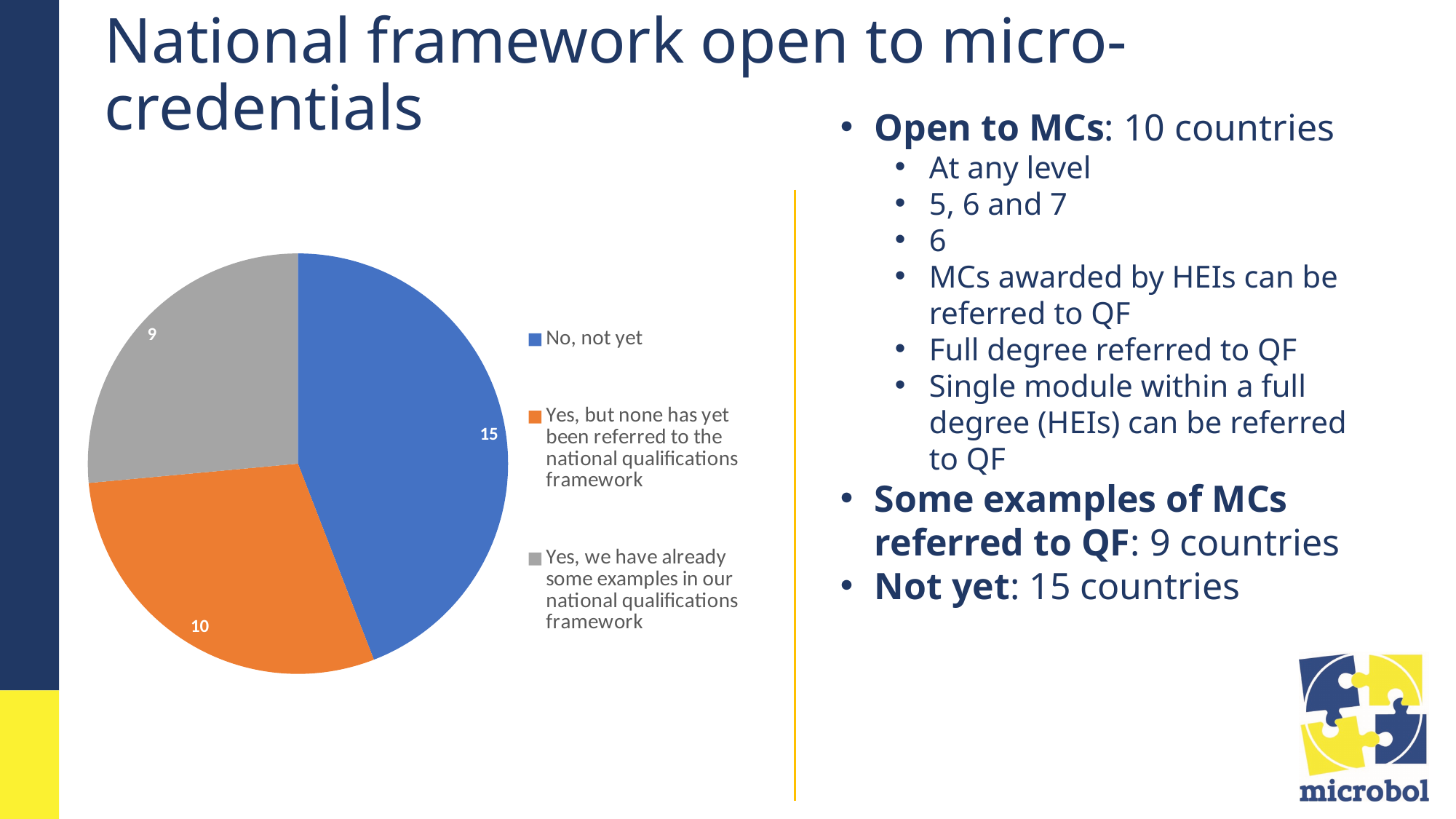
What colour is the 'No, not yet' slice in the pie chart? Blue Which category has the smallest slice in the pie chart? Yes, we have already some examples in our national qualifications framework What colour is the 'Yes, we have already some examples in our national qualifications framework' slice? Grey Which is larger: the 'Yes, but none has yet been referred to the national qualifications framework' slice or the 'Yes, we have already some examples in our national qualifications framework' slice? Yes, but none has yet been referred to the national qualifications framework What type of chart is shown on the slide? Pie chart What is the difference between the 'No, not yet' value and the 'Yes, but none has yet been referred to the national qualifications framework' value? 5 What is the value of the 'Yes, we have already some examples in our national qualifications framework' slice? 9 What is the value of the 'No, not yet' slice in the pie chart? 15 What is the value of the 'Yes, but none has yet been referred to the national qualifications framework' slice? 10 How many slices does the pie chart have? 3 What is the total of all the values shown in the pie chart? 34 Which category has the largest slice in the pie chart? No, not yet